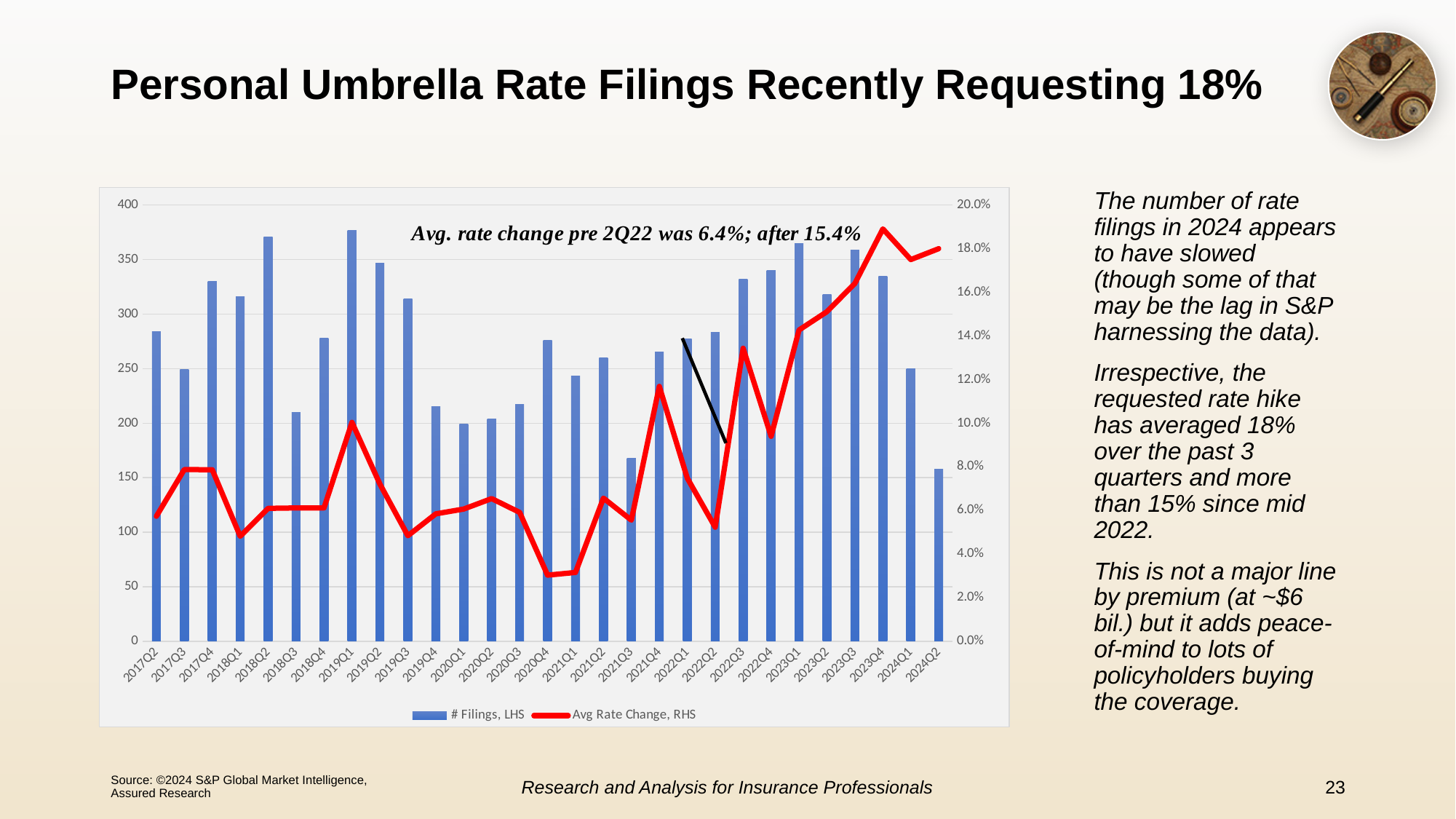
Is the average rate change for 2020Q4 greater or less than 4.0%? less How many quarters are plotted along the x axis of the chart? 29 Is the average rate change for 2023Q4 greater or less than 18.0%? greater What kind of chart is shown on the slide? A combined bar and line chart According to the annotation on the chart, what was the average rate change after 2Q22? 15.4% Does the average rate change line rise or fall from 2022Q2 to 2023Q4? It rises Which quarter has more filings, 2023Q1 or 2024Q1? 2023Q1 Which quarter has the lowest number of filings (bar)? 2024Q2 Is the number of filings for 2019Q1 greater or less than 350? greater How many series does the chart legend list? 2 Which quarter has the highest average rate change (red line)? 2023Q4